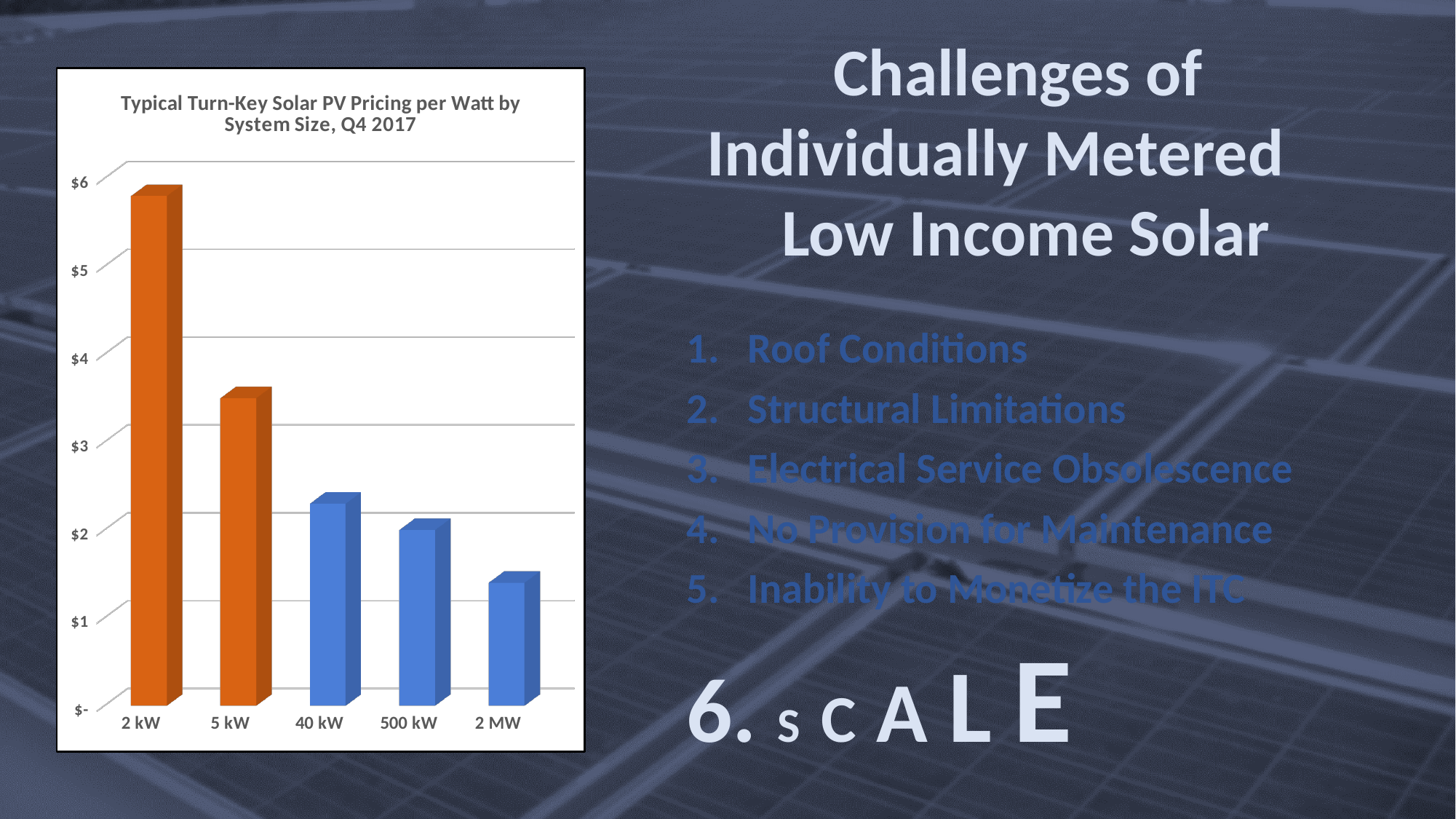
What kind of chart is shown on the slide? Bar chart Which system size has the lowest price per watt? 2 MW Which system size has the highest price per watt? 2 kW Is the value for 5 kW greater or less than $3? greater Is the value for 2 MW greater or less than $2? less What is the title of the chart? Typical Turn-Key Solar PV Pricing per Watt by System Size, Q4 2017 Which has a higher price per watt, 2 kW or 5 kW? 2 kW How many system size categories are shown on the chart? 5 Is the value for 2 MW greater or less than $1? greater Do the values rise or fall as system size increases from 2 kW to 2 MW? Fall Which system size categories are shown with orange bars? 2 kW and 5 kW